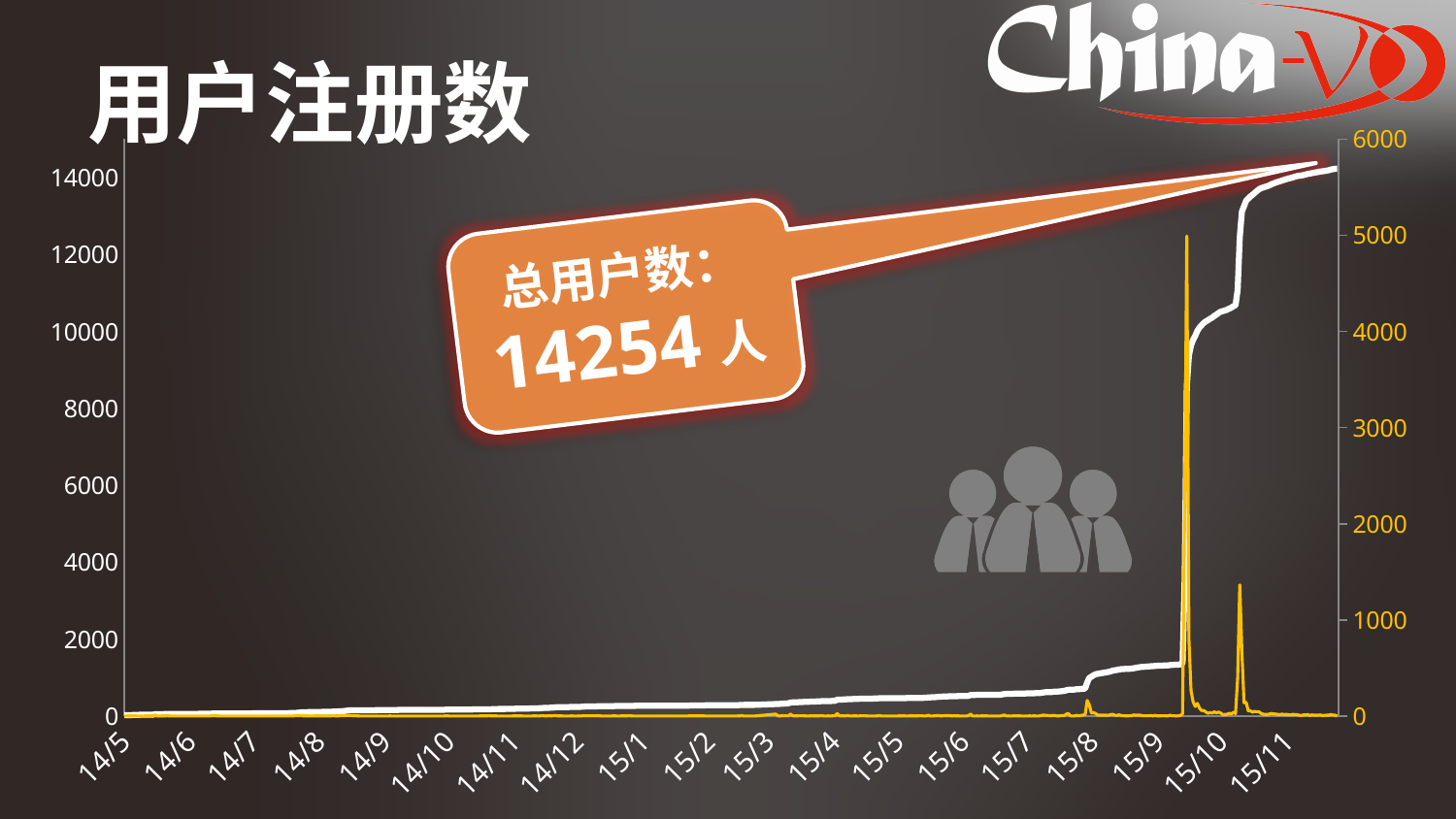
Is the value of the white line at 15/11 greater or less than 12000 on the left axis? greater Does the white line rise or fall from 14/5 to 15/11? rise Is the highest peak of the yellow line greater or less than 4000 on the right axis? greater What kind of chart is shown on the slide? line chart Is the second yellow peak, just after 15/10, greater or less than 2000 on the right axis? less Which is larger for the white line: the value at 15/11 or the value at 15/8? 15/11 Around which x-axis label does the yellow line reach its highest peak? 15/9 What is the title of the chart? 用户注册数 What is the total number of users stated in the callout on the chart? 14254 人 What is the highest tick value on the left vertical axis? 14000 How many labels are shown on the x axis? 19